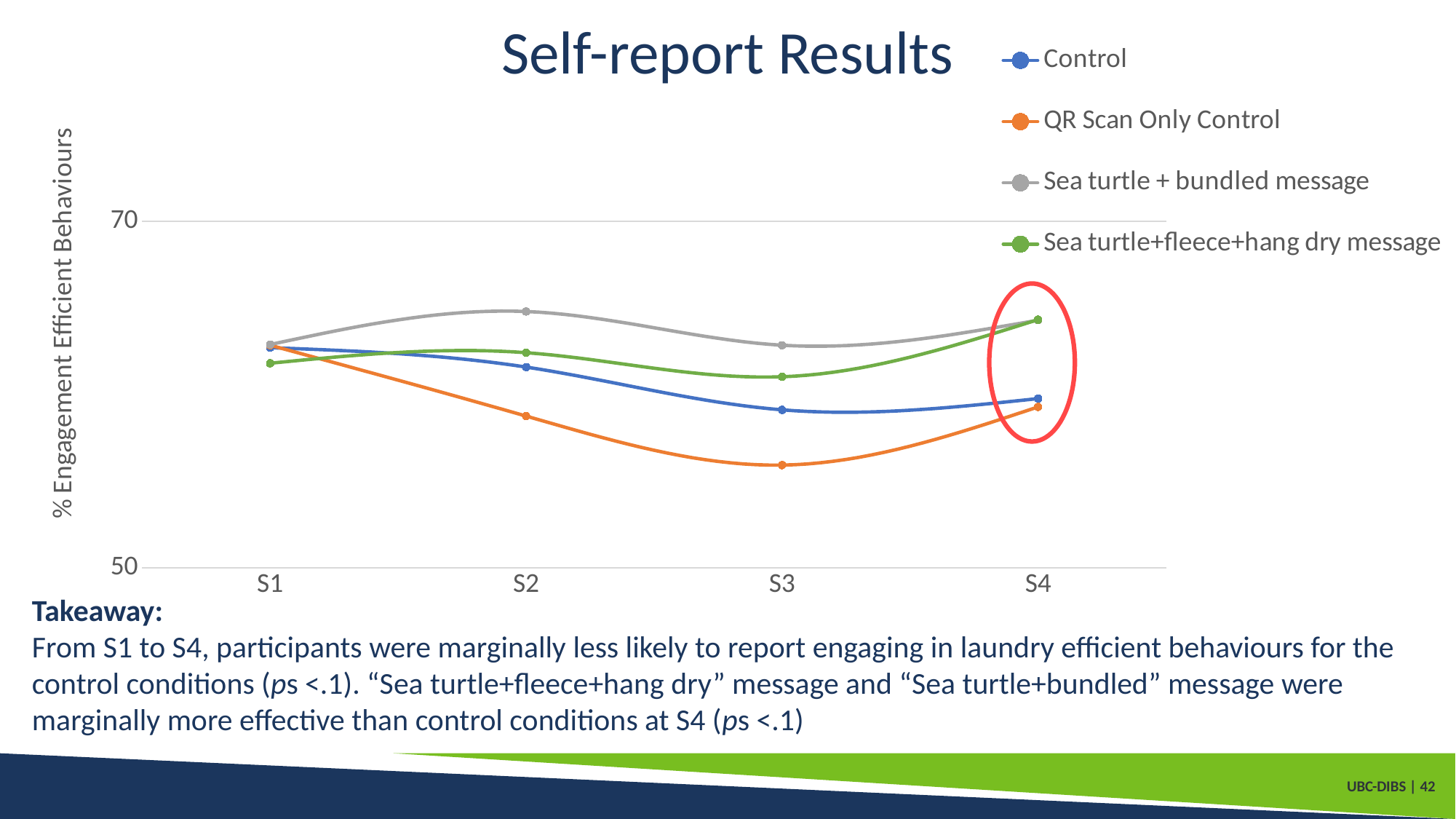
How many time points are shown on the x axis? 4 What is the label of the y axis? % Engagement Efficient Behaviours Does the Sea turtle+fleece+hang dry message series rise or fall from S3 to S4? rise Which series has the lowest value at S3? QR Scan Only Control How many series does the legend list? 4 Is the value for Sea turtle + bundled message at S2 greater or less than 70? less At S3, which is larger: the value for Control or the value for Sea turtle + bundled message? Sea turtle + bundled message What is the title of the chart? Self-report Results Which series has the highest value at S2? Sea turtle + bundled message What kind of chart is shown on the slide? line chart Does the QR Scan Only Control series rise or fall from S1 to S3? fall At S4, which is larger: the value for Sea turtle+fleece+hang dry message or the value for QR Scan Only Control? Sea turtle+fleece+hang dry message